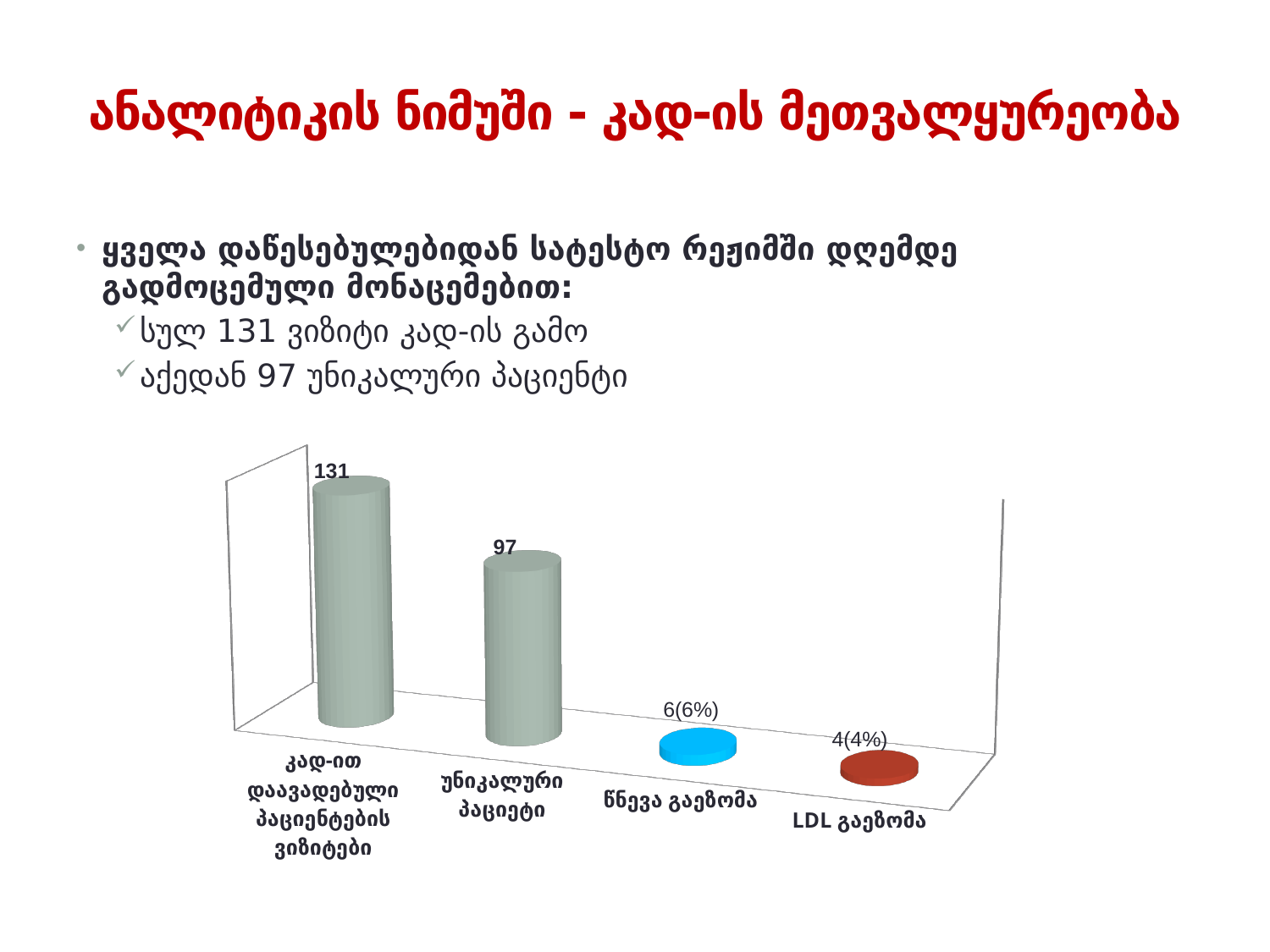
Do the values rise or fall from left to right across the categories? fall What is the value for უნიკალური პაციეტი? 97 Which is larger, the value for უნიკალური პაციეტი or the value for წნევა გაეზომა? უნიკალური პაციეტი Which category has the lowest value? LDL გაეზომა How many categories are shown in the chart? 4 What is the difference between the values for კად-ით დაავადებული პაციენტების ვიზიტები and უნიკალური პაციეტი? 34 What is the difference between the values for წნევა გაეზომა and LDL გაეზომა? 2 What is the value for კად-ით დაავადებული პაციენტების ვიზიტები? 131 What data label is shown for LDL გაეზომა? 4(4%) What kind of chart is shown on the slide? bar chart What data label is shown for წნევა გაეზომა? 6(6%) Which category has the highest value? კად-ით დაავადებული პაციენტების ვიზიტები